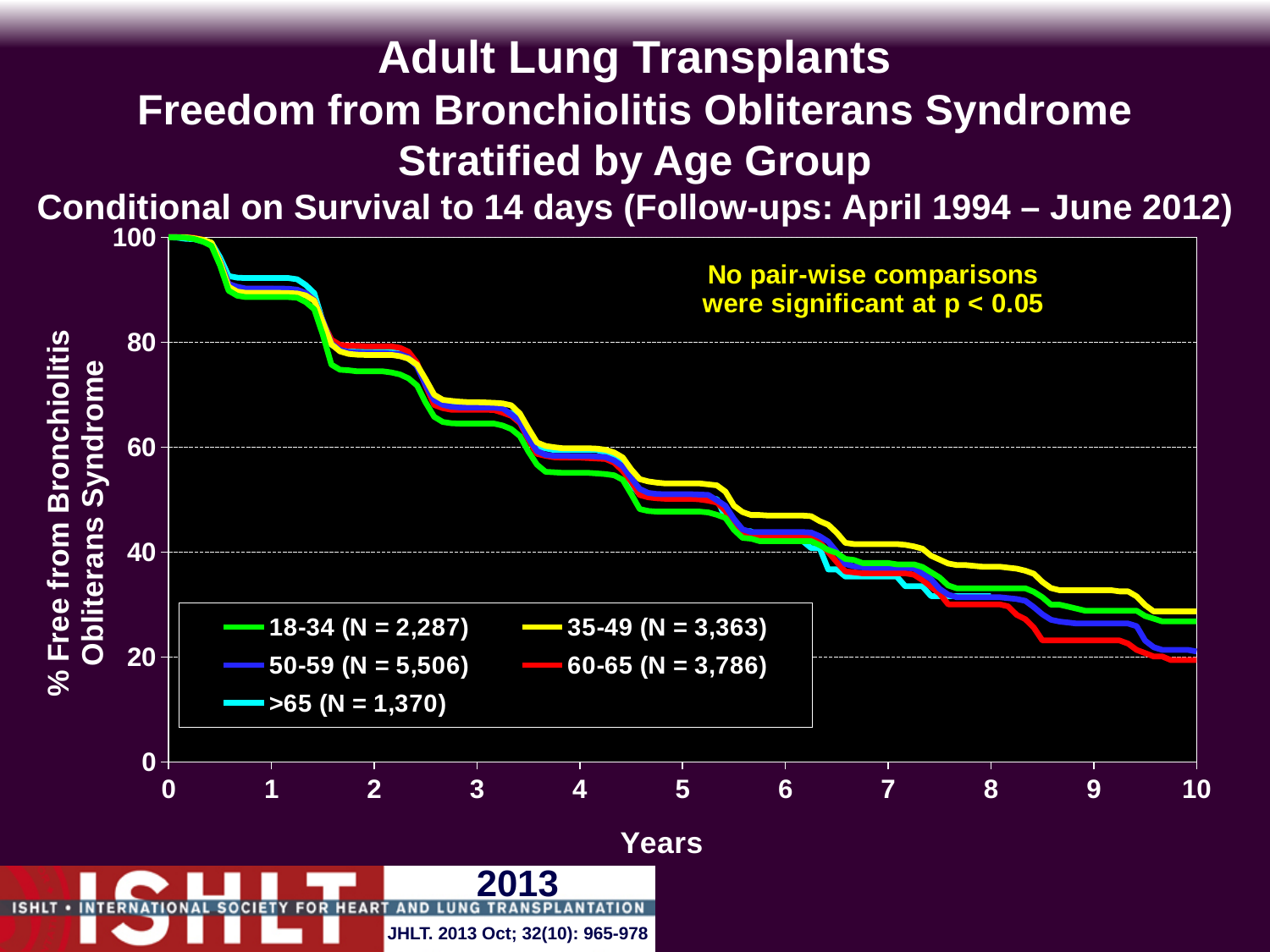
Which age group has the highest value at 9 years? 35-49 What kind of chart is shown on the slide? line chart Is the value for the 60-65 age group at 8 years greater or less than 40? less Is the value for the 18-34 age group at 2 years greater or less than 80? less Is the value for the 35-49 age group at 5 years greater or less than 40? greater What is the label of the x axis? Years Which age group has the lowest value at 9 years? 60-65 Do the values for each age group rise or fall as the years increase? fall What is the N shown in the legend for the 50-59 age group? 5,506 How many age groups does the legend list? 5